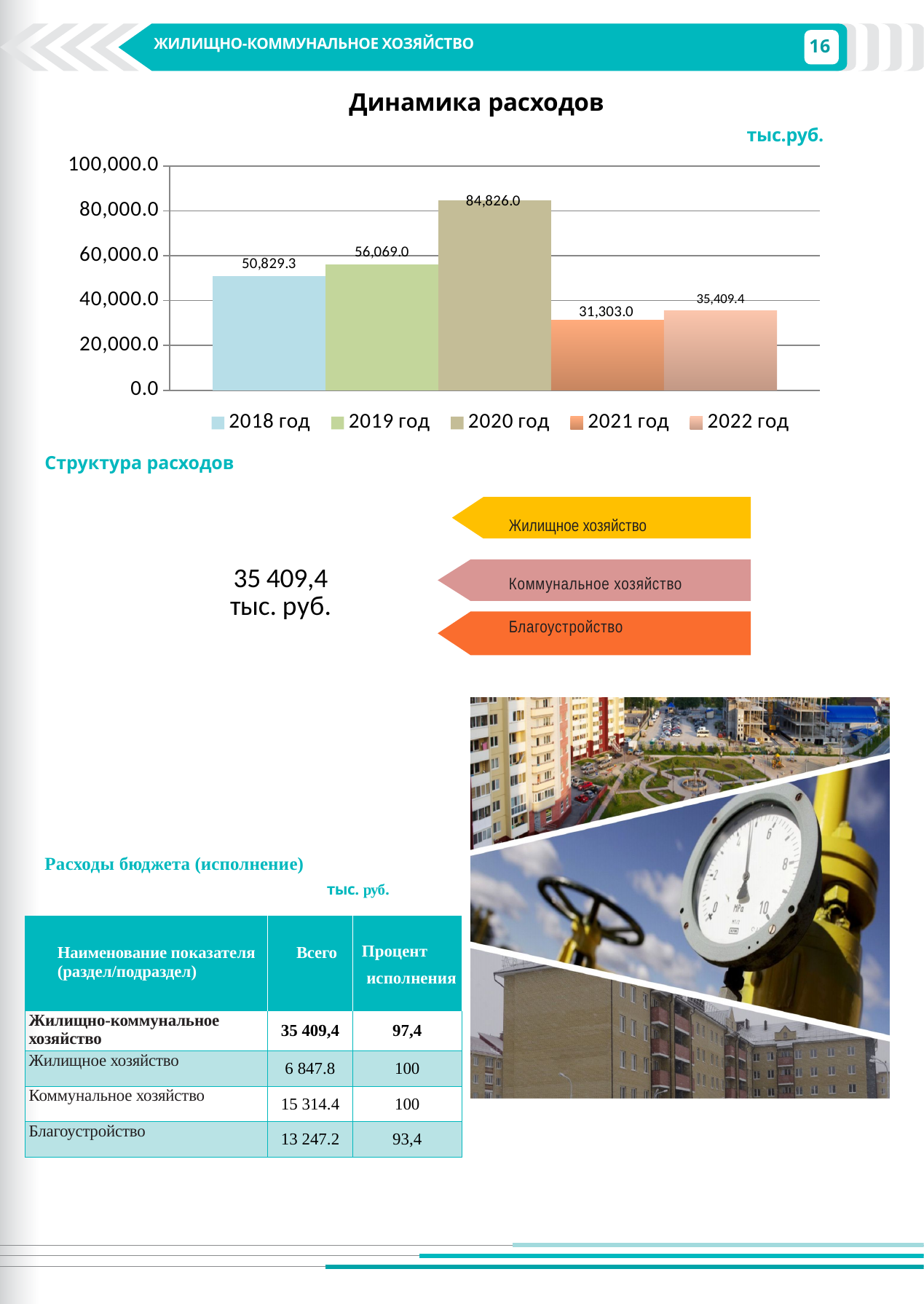
What unit is indicated above the chart 'Динамика расходов'? тыс.руб. In the chart 'Динамика расходов', is the value for 2021 год greater or less than 40,000.0? less What kind of chart is 'Динамика расходов'? bar chart In the chart 'Динамика расходов', which year has the lowest value? 2021 год In the chart 'Динамика расходов', what is the value for 2018 год? 50,829.3 In the chart 'Динамика расходов', what is the difference between the values for 2020 год and 2019 год? 28,757.0 In the chart 'Динамика расходов', which year has the highest value? 2020 год In the chart 'Динамика расходов', what is the value for 2020 год? 84,826.0 In the chart 'Динамика расходов', which is larger: the value for 2019 год or the value for 2022 год? 2019 год In the chart 'Динамика расходов', what is the difference between the values for 2022 год and 2021 год? 4,106.4 In the chart 'Динамика расходов', what is the value for 2022 год? 35,409.4 How many bars are plotted in the chart 'Динамика расходов'? 5